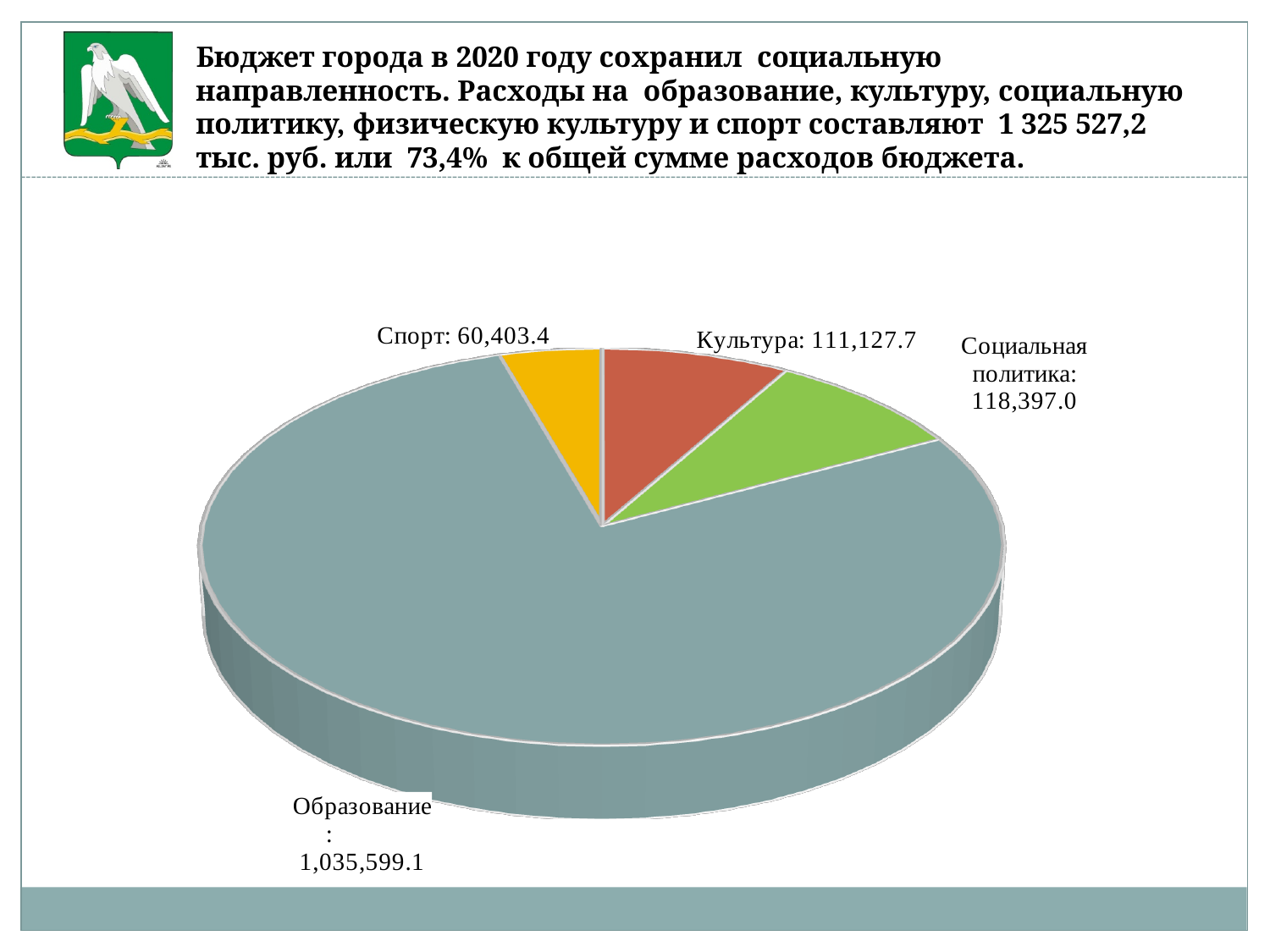
What is the value shown for Социальная политика in the pie chart? 118,397.0 What type of chart is shown on the slide? Pie chart What is the difference between the values for Культура and Спорт? 50,724.3 Which is larger, the value for Социальная политика or the value for Культура? Социальная политика What is the value shown for Спорт in the pie chart? 60,403.4 Which category has the smallest slice in the pie chart? Спорт What is the value shown for Образование in the pie chart? 1,035,599.1 Which category has the largest slice in the pie chart? Образование What colour is the Спорт slice in the pie chart? Yellow What is the difference between the values for Социальная политика and Культура? 7,269.3 How many categories are shown in the pie chart? 4 What is the value shown for Культура in the pie chart? 111,127.7